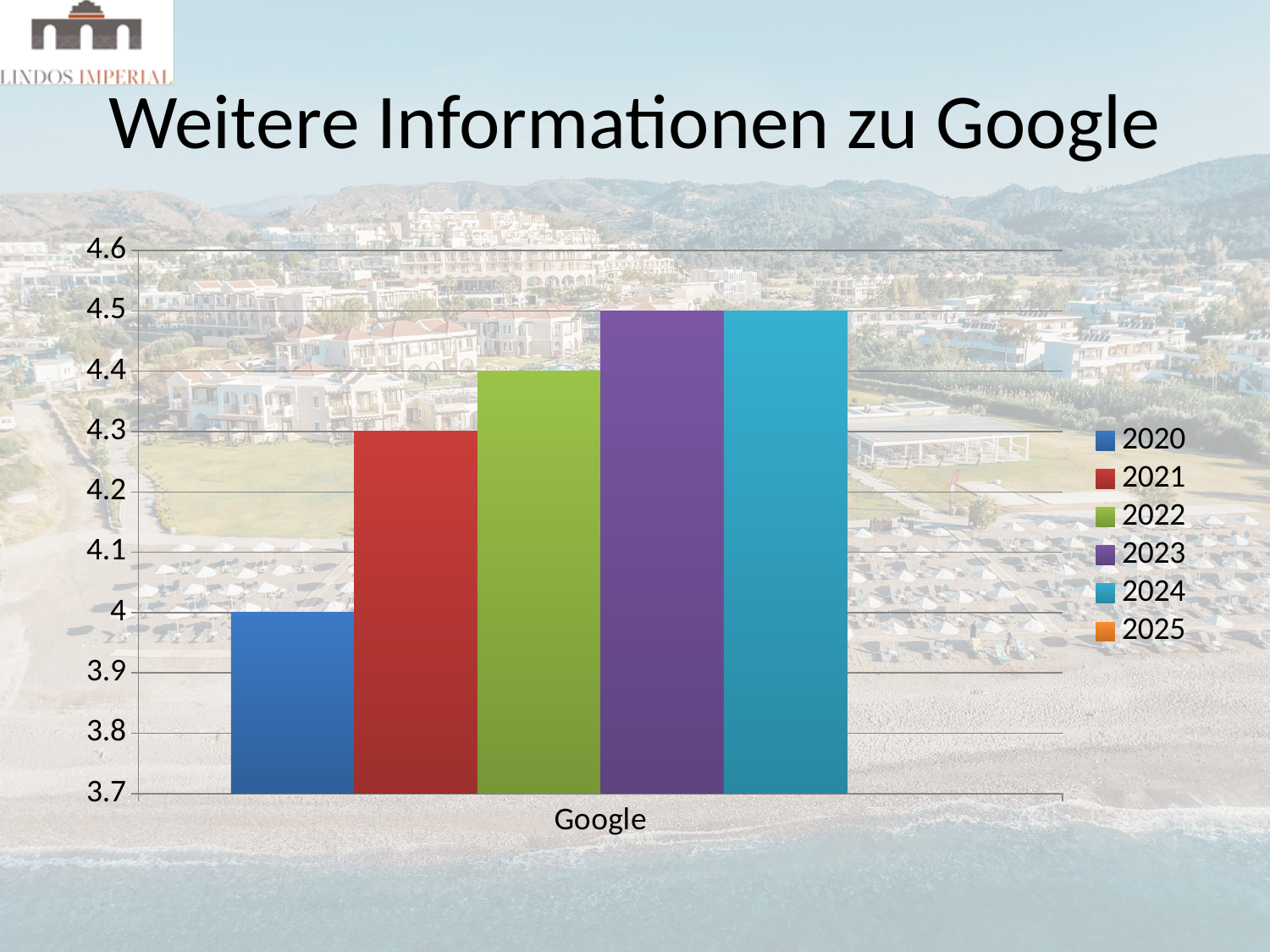
Which is larger, the value for 2021 or the value for 2022? 2022 What is the value for 2020 in the Google category? 4 What kind of chart is shown on the slide? bar chart How many categories are shown on the x axis? 1 What is the value for 2023 in the Google category? 4.5 What is the value for 2021 in the Google category? 4.3 Do the values rise or fall from 2020 to 2024? rise What is the value for 2022 in the Google category? 4.4 Which year has the lowest value in the chart? 2020 What is the difference between the values for 2023 and 2020? 0.5 How many series does the legend list? 6 What is the title of the slide? Weitere Informationen zu Google